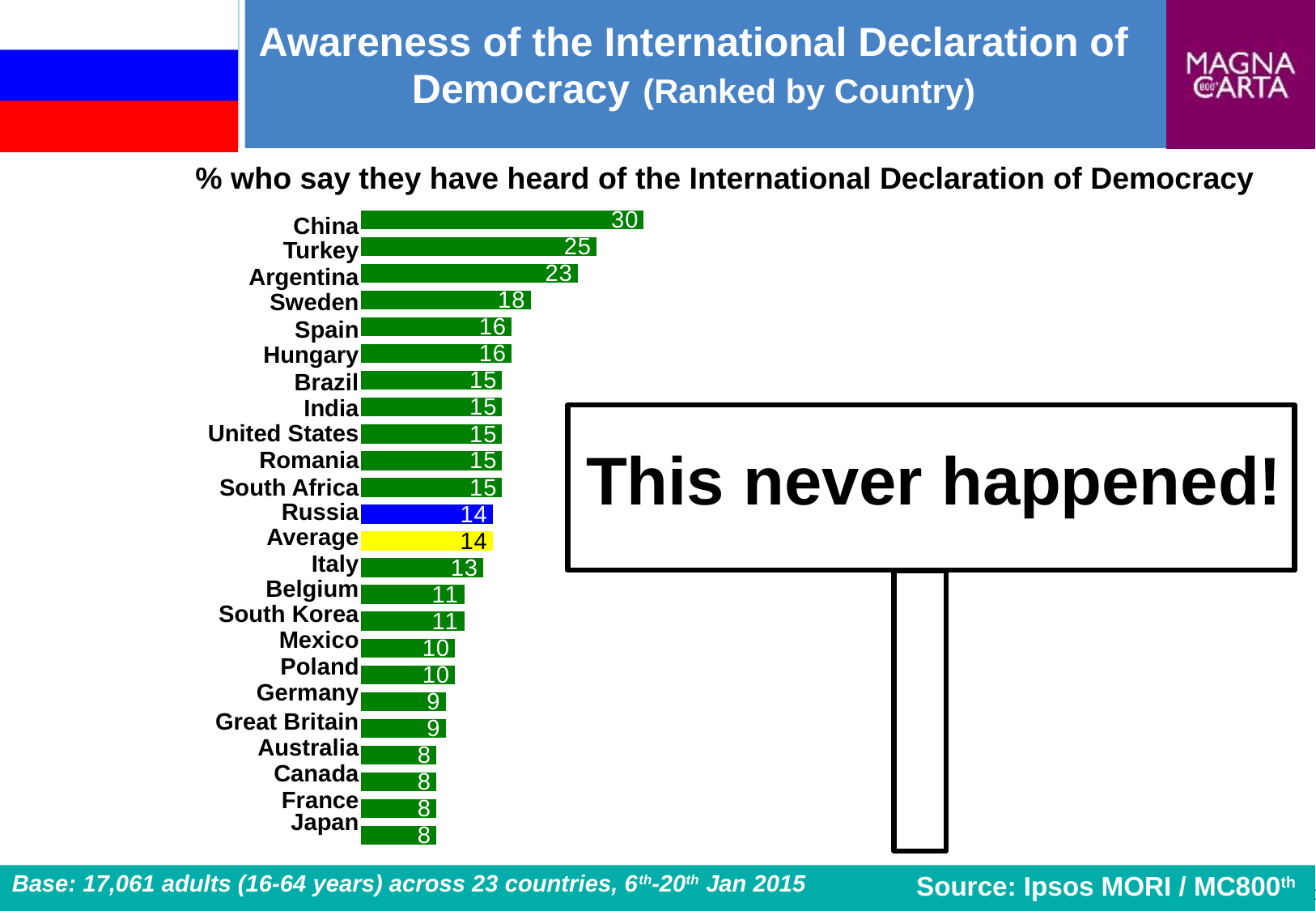
How many bars are plotted in the chart? 24 What colour is the bar for Russia? Blue Which has a larger value, Sweden or Spain? Sweden What is the difference between the values for China and Turkey? 5 What is the value shown for the Average bar? 14 What is the value shown for Russia? 14 What is the value shown for China? 30 Which has a larger value, Italy or Belgium? Italy What is the value shown for Sweden? 18 What is the difference between the values for Argentina and Japan? 15 What type of chart is shown on the slide? Bar chart Which country has the highest value in the chart? China